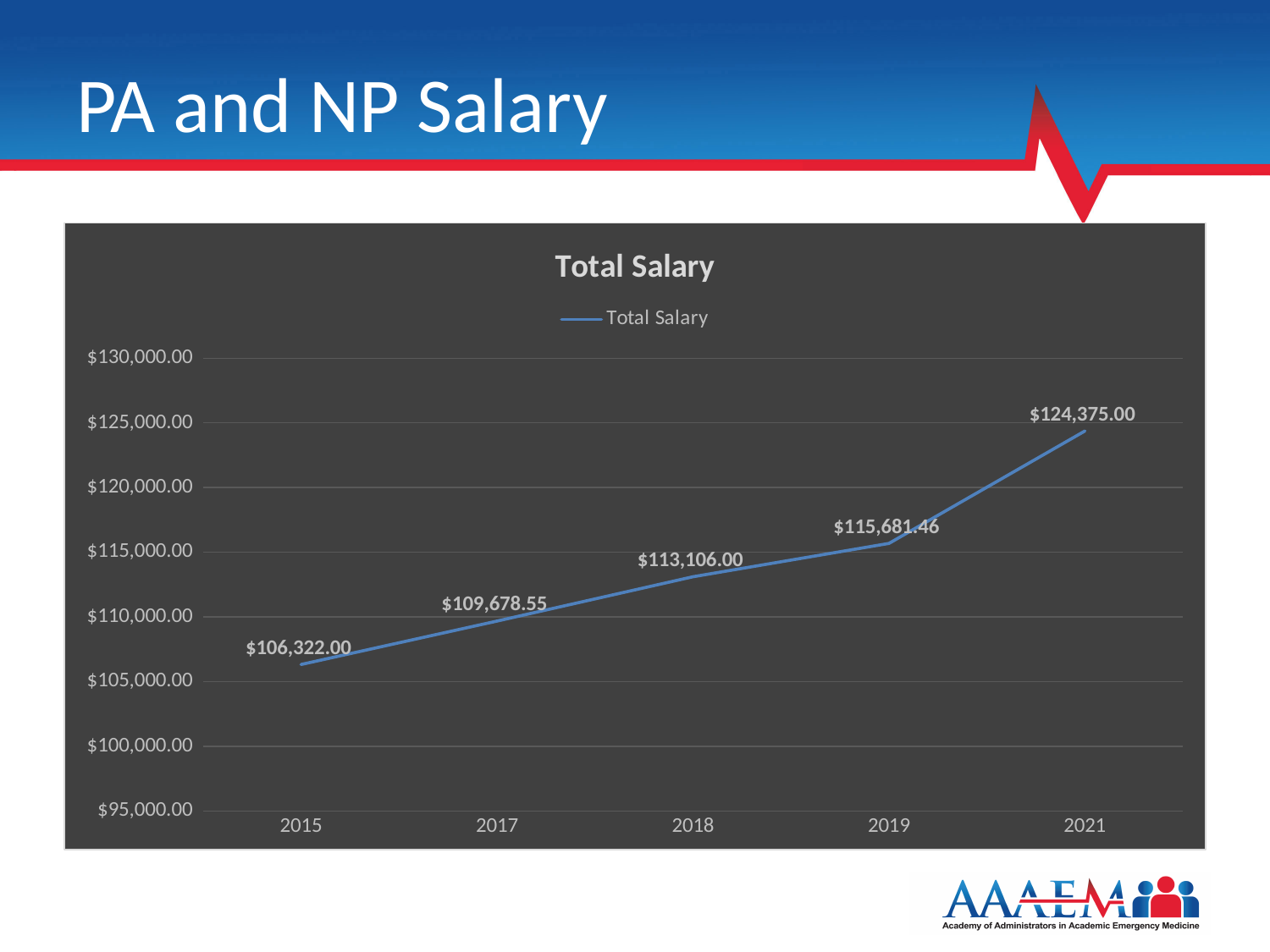
How many years are plotted on the x axis? 5 What is the difference in Total Salary between 2021 and 2015? $18,053.00 What is the difference in Total Salary between 2019 and 2018? $2,575.46 What kind of chart is shown on the slide? Line chart Which year has a larger Total Salary, 2017 or 2018? 2018 What is the Total Salary value for 2015? $106,322.00 Is the Total Salary for 2021 greater or less than $120,000.00? greater Does the Total Salary rise or fall from 2015 to 2021? Rise Which year has the highest Total Salary? 2021 What is the Total Salary value for 2019? $115,681.46 What is the Total Salary value for 2021? $124,375.00 Which year has the lowest Total Salary? 2015